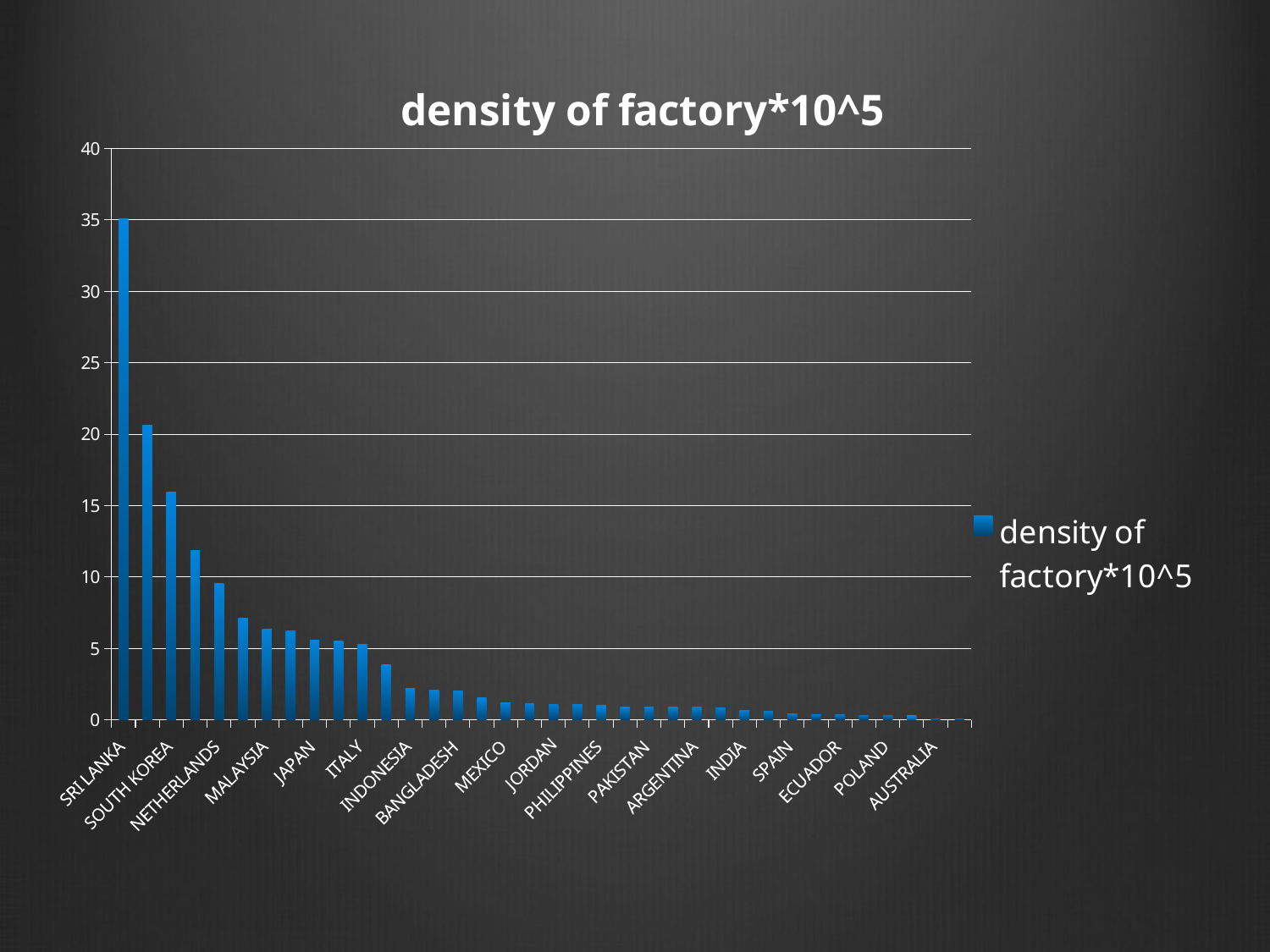
What kind of chart is shown on the slide? bar chart Which has a larger value, JAPAN or MEXICO? JAPAN Is the value for INDONESIA greater or less than 5? less Is the value for MEXICO greater or less than 5? less Do the values rise or fall moving from left to right along the x axis? fall Is the value for SOUTH KOREA greater or less than 15? greater How many series does the legend list? 1 Which has a larger value, SRI LANKA or SOUTH KOREA? SRI LANKA What is the title of the chart? density of factory*10^5 Which country has the highest value in the chart? SRI LANKA